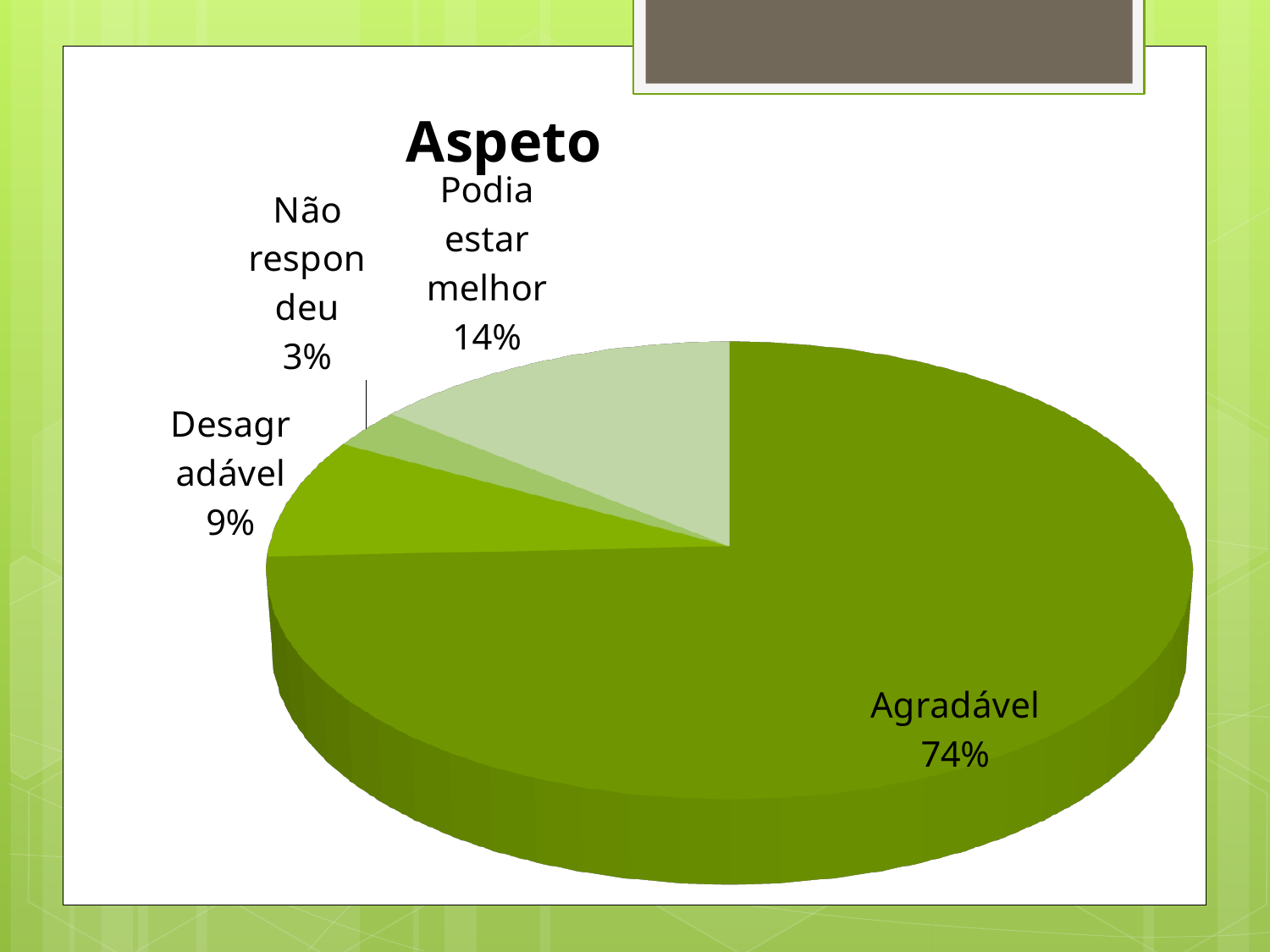
Which category has the smallest share of the pie? Não respondeu What percentage of the pie is labelled Agradável? 74% What percentage of the pie is labelled Desagradável? 9% Which category has the largest share of the pie? Agradável What kind of chart is shown on the slide? pie chart How many slices does the pie chart have? 4 What percentage of the pie is labelled Podia estar melhor? 14% What is the title of the chart? Aspeto What is the difference in percentage points between Agradável and Podia estar melhor? 60 Which is larger, the share for Desagradável or the share for Podia estar melhor? Podia estar melhor What is the combined share of Desagradável and Não respondeu? 12% What percentage of the pie is labelled Não respondeu? 3%